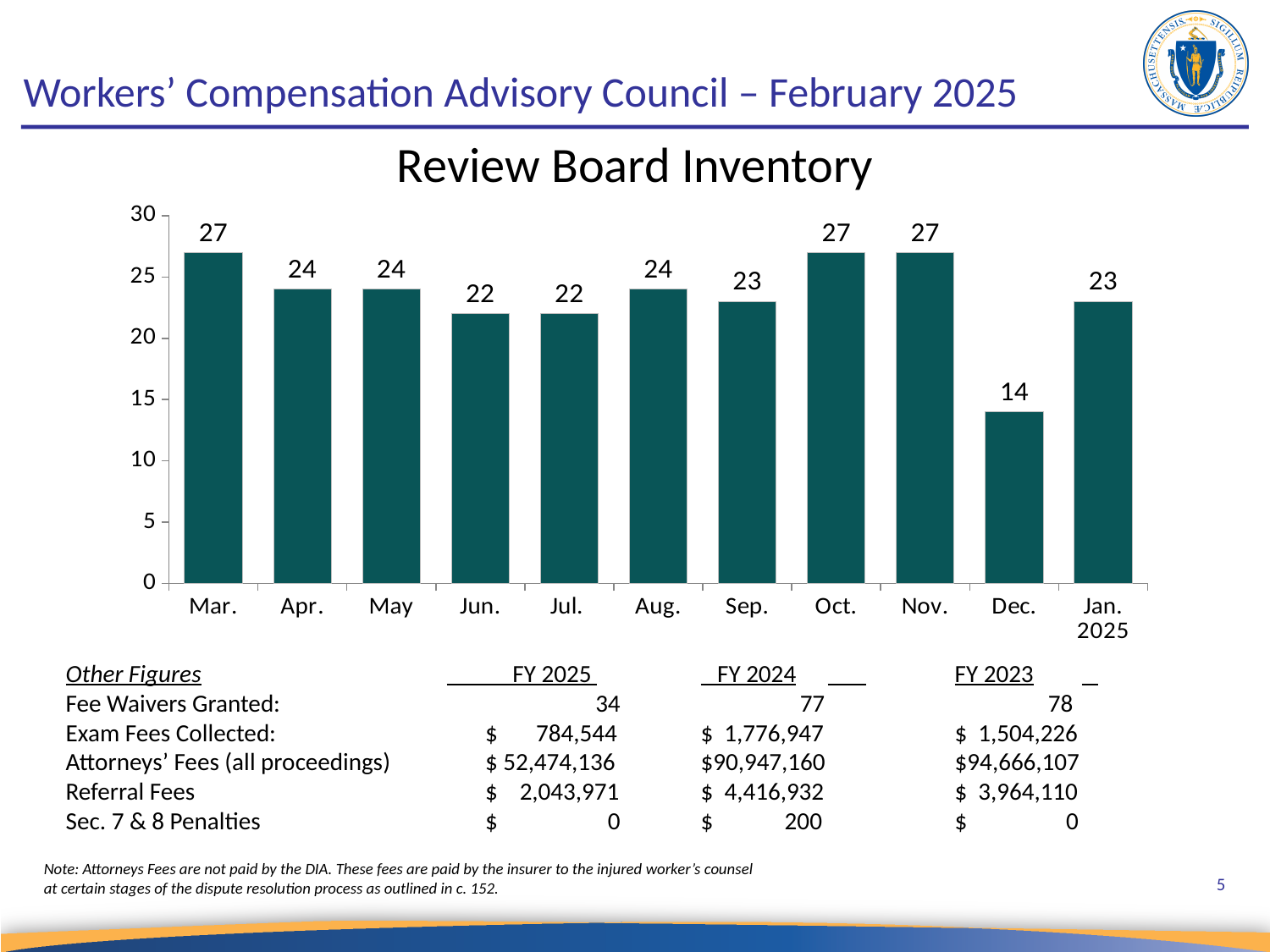
What is the difference between the Review Board Inventory for Mar. and Jun.? 5 Which month has the lowest Review Board Inventory? Dec. What is the Review Board Inventory value for Mar.? 27 What kind of chart is the Review Board Inventory chart? bar chart Is the Review Board Inventory value for Dec. greater or less than 15? less Does the Review Board Inventory rise or fall from Nov. to Dec.? fall How many months are shown in the Review Board Inventory chart? 11 What is the Review Board Inventory value for Dec.? 14 What is the Review Board Inventory value for Jan. 2025? 23 What is the title of the chart on the slide? Review Board Inventory What is the difference between the Review Board Inventory for Nov. and Dec.? 13 Which is larger, the Review Board Inventory for Aug. or for Sep.? Aug.